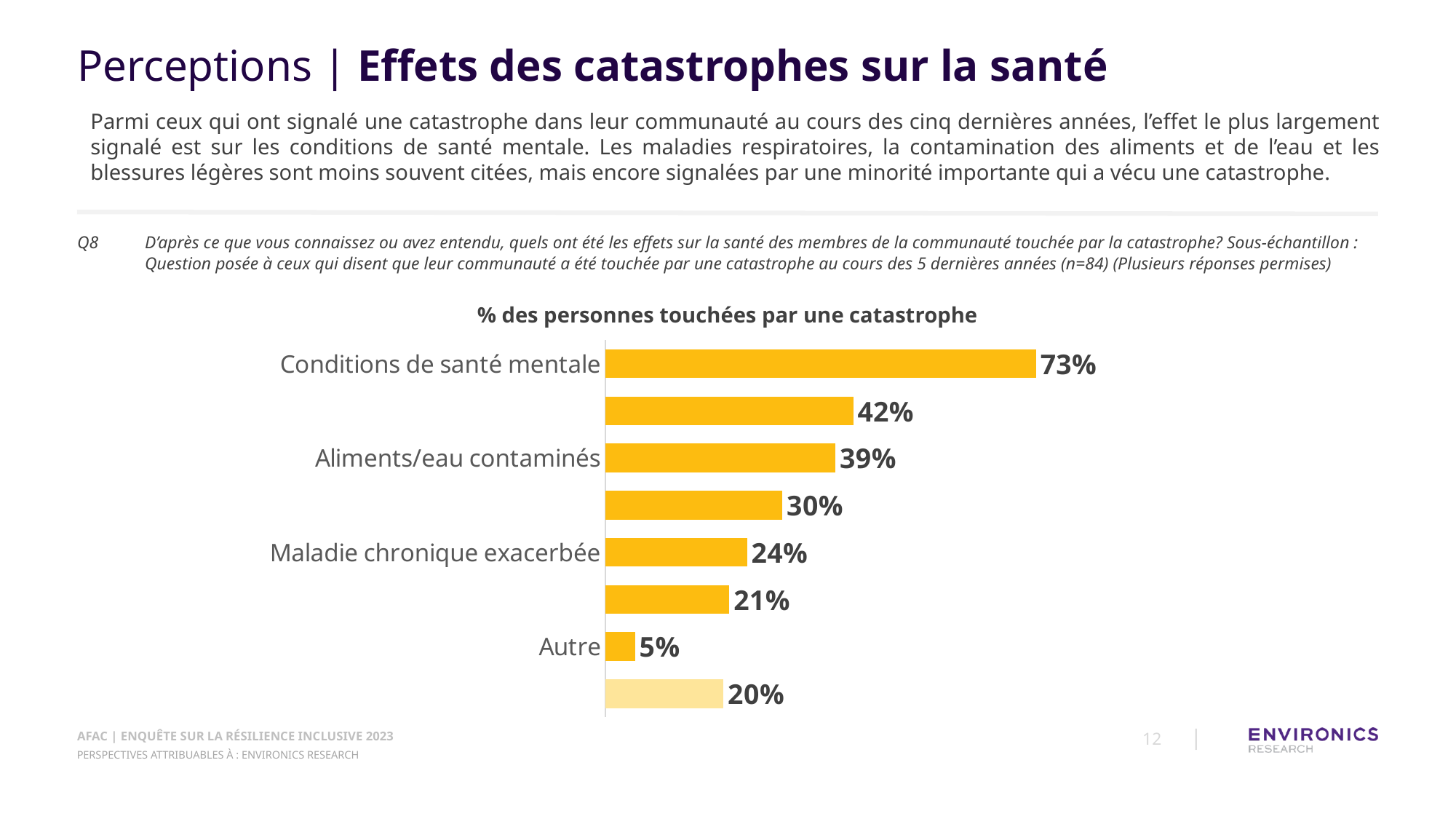
What is the title of the chart? % des personnes touchées par une catastrophe What is the difference in percentage points between Conditions de santé mentale and Aliments/eau contaminés? 34 percentage points What kind of chart is shown on the slide? Bar chart How many bars are plotted in the chart? 8 What is the difference in percentage points between Maladie chronique exacerbée and Autre? 19 percentage points Which category has the lowest value in the chart? Autre Which is larger: the value for Aliments/eau contaminés or the value for Maladie chronique exacerbée? Aliments/eau contaminés What percentage is shown for Conditions de santé mentale? 73% Which category has the highest value in the chart? Conditions de santé mentale What percentage is shown for Aliments/eau contaminés? 39% What percentage is shown for Maladie chronique exacerbée? 24% What percentage is shown for Autre? 5%